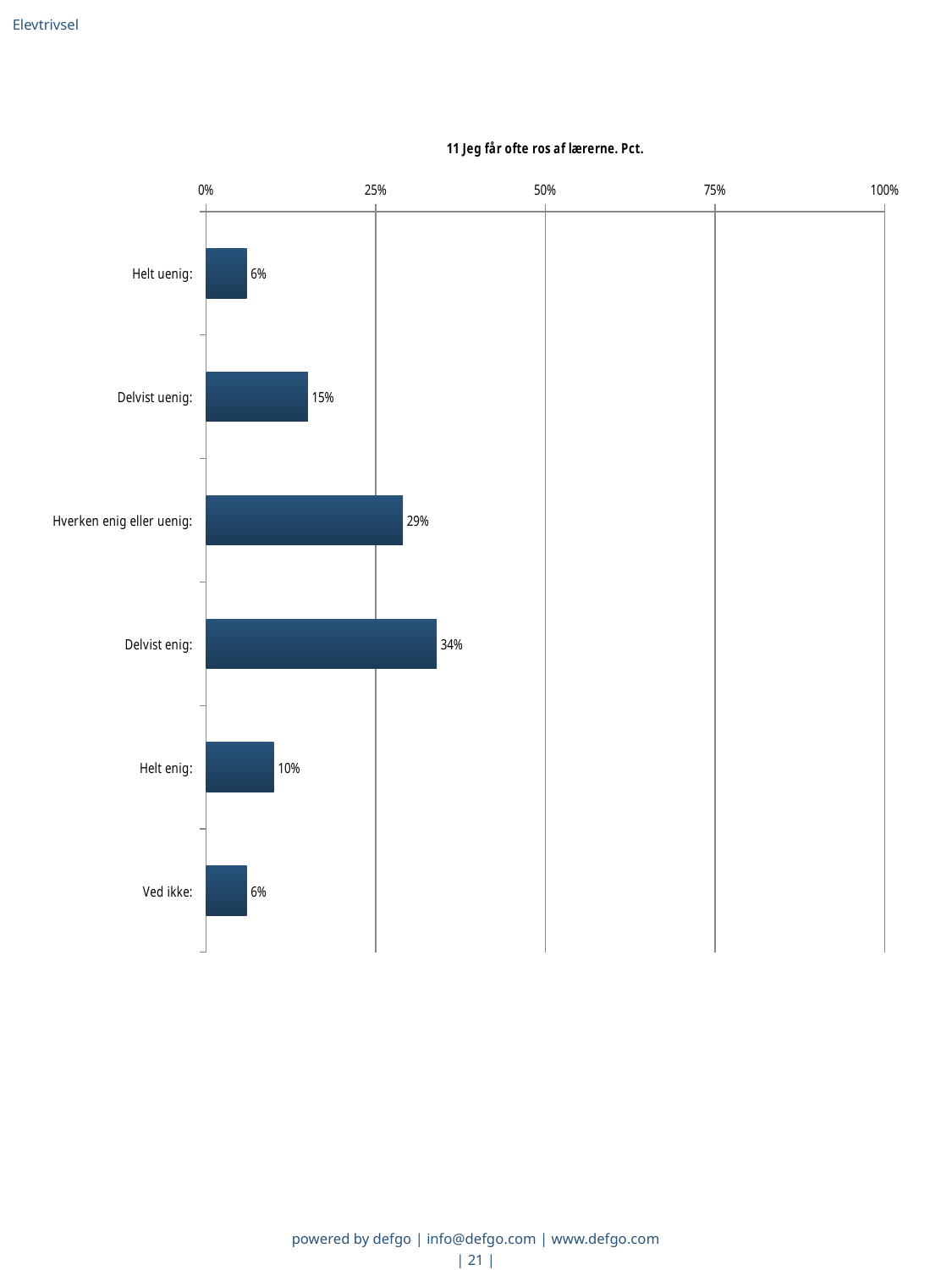
What kind of chart is shown on the slide? Bar chart How many categories are shown in the chart? 6 Which category has the highest value? Delvist enig What is the difference between the values for "Delvist uenig" and "Helt enig"? 5% Which is larger, the value for "Delvist uenig" or the value for "Helt enig"? Delvist uenig What is the value for "Delvist uenig"? 15% What is the difference between the values for "Delvist enig" and "Hverken enig eller uenig"? 5% What is the title of the chart? 11 Jeg får ofte ros af lærerne. Pct. What is the value for "Delvist enig"? 34% What is the value for "Helt enig"? 10% Is the value for "Delvist enig" greater or less than 25%? greater What is the value for "Hverken enig eller uenig"? 29%